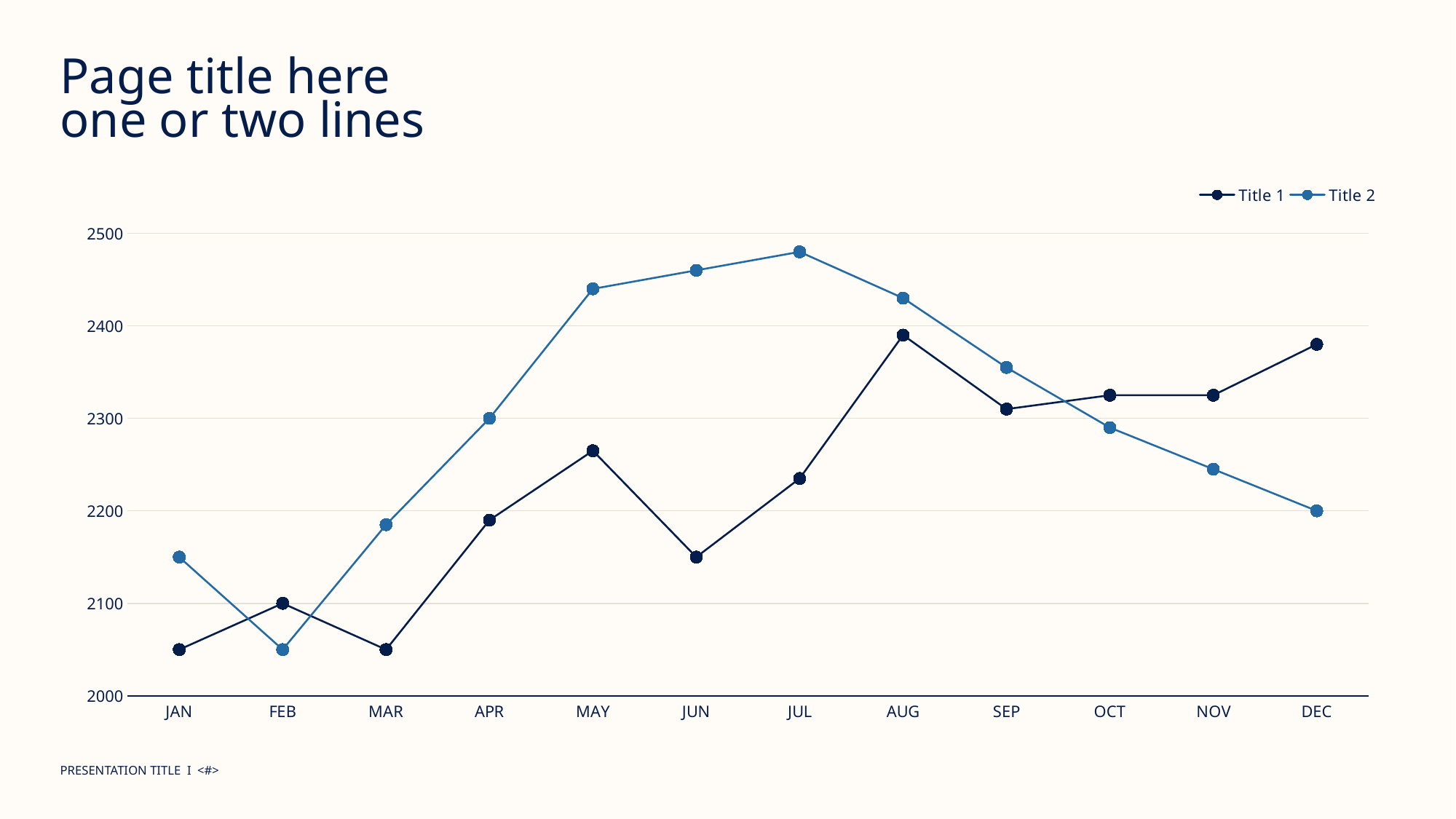
Which series has the larger value in DEC, Title 1 or Title 2? Title 1 Is the value for Title 1 in JUN greater or less than 2200? less Does Title 2 rise or fall from JUL to DEC? fall In which month does Title 2 reach its highest value? JUL What kind of chart is shown on the slide? line chart What is the value for Title 2 in APR? 2300 What is the value for Title 1 in FEB? 2100 What is the value for Title 2 in DEC? 2200 In which month does Title 1 reach its highest value? AUG How many months are plotted along the x axis? 12 Is the value for Title 2 in MAY greater or less than 2400? greater How many series does the legend list? 2